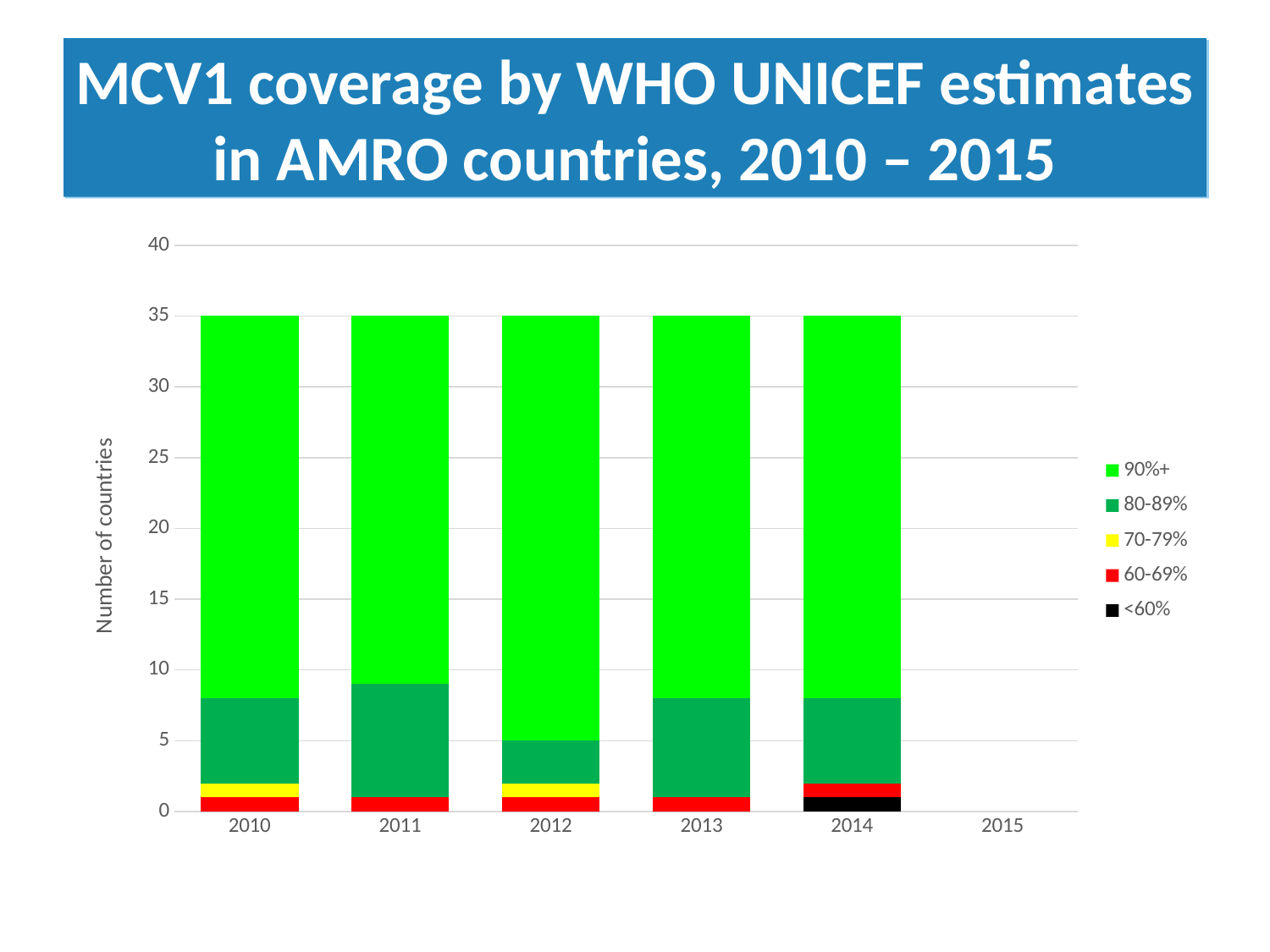
Which year has the larger 80-89% segment, 2011 or 2012? 2011 Is the value for the 90%+ segment in 2012 greater or less than 25? greater Is the value for the 80-89% segment in 2011 greater or less than 5? greater How many years are labelled on the x axis? 6 What is the title of the y axis? Number of countries How many years have a bar plotted? 5 How many series does the legend list? 5 Which year has the largest 80-89% segment? 2011 What is the total height of the stacked bar for 2010? 35 What kind of chart is shown on the slide? Stacked bar chart Which year has the smallest 80-89% segment? 2012 Which year is the only one with a <60% segment? 2014